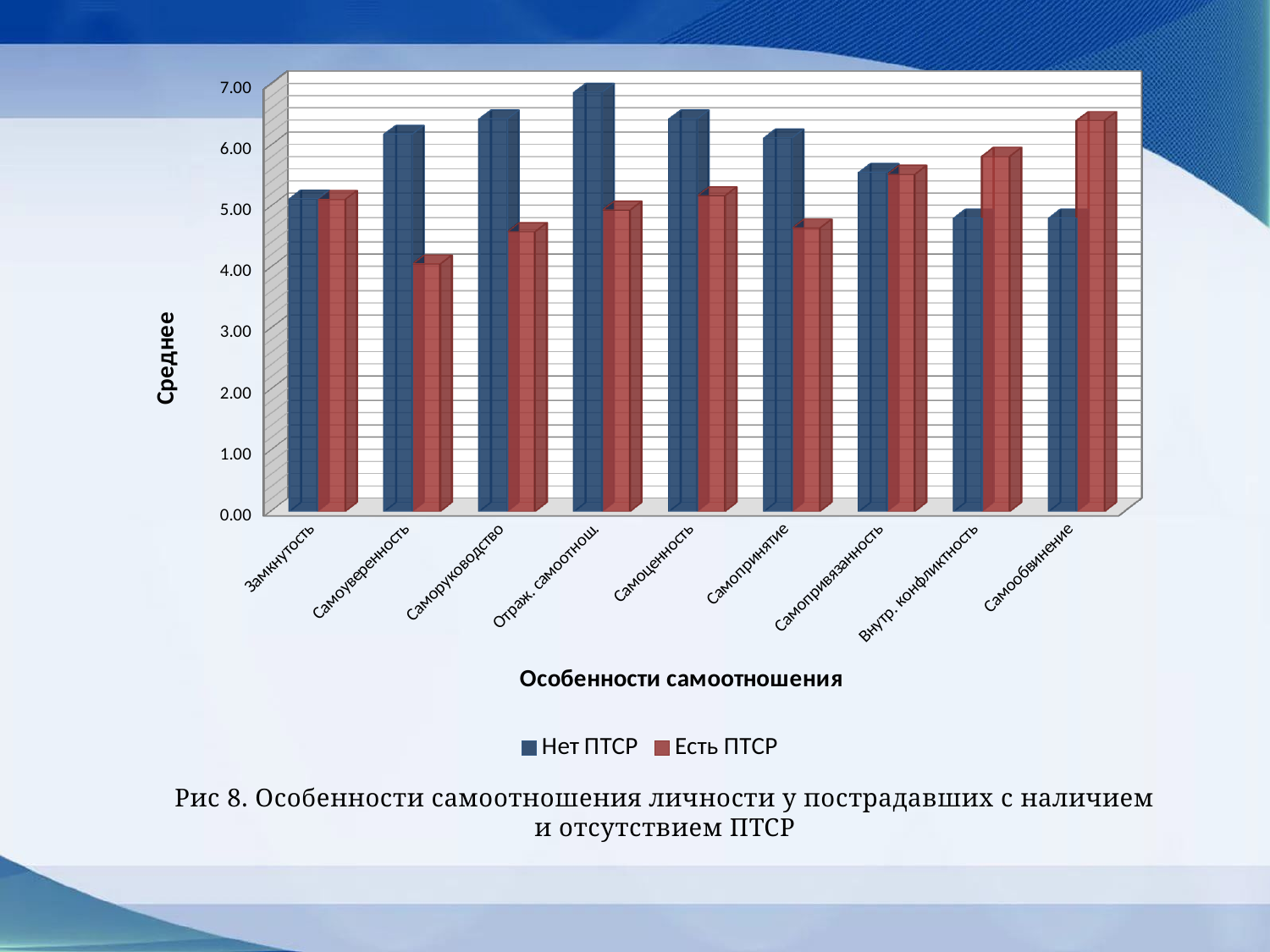
Which category has the highest value for the Нет ПТСР series? Отраж. самоотнош. What is the title of the vertical axis of the chart? Среднее How many categories are shown along the x axis of the chart? 9 Is the value for Есть ПТСР at Самоуверенность greater or less than 5.00? less What is the title of the horizontal axis of the chart? Особенности самоотношения Which category has the highest value for the Есть ПТСР series? Самообвинение For Самоуверенность, which series has the larger value: Нет ПТСР or Есть ПТСР? Нет ПТСР How many series does the chart legend list? 2 Which category has the lowest value for the Есть ПТСР series? Самоуверенность Is the value for Нет ПТСР at Отраж. самоотнош. greater or less than 6.00? greater What kind of chart is shown on the slide? bar chart For Самообвинение, which series has the larger value: Нет ПТСР or Есть ПТСР? Есть ПТСР